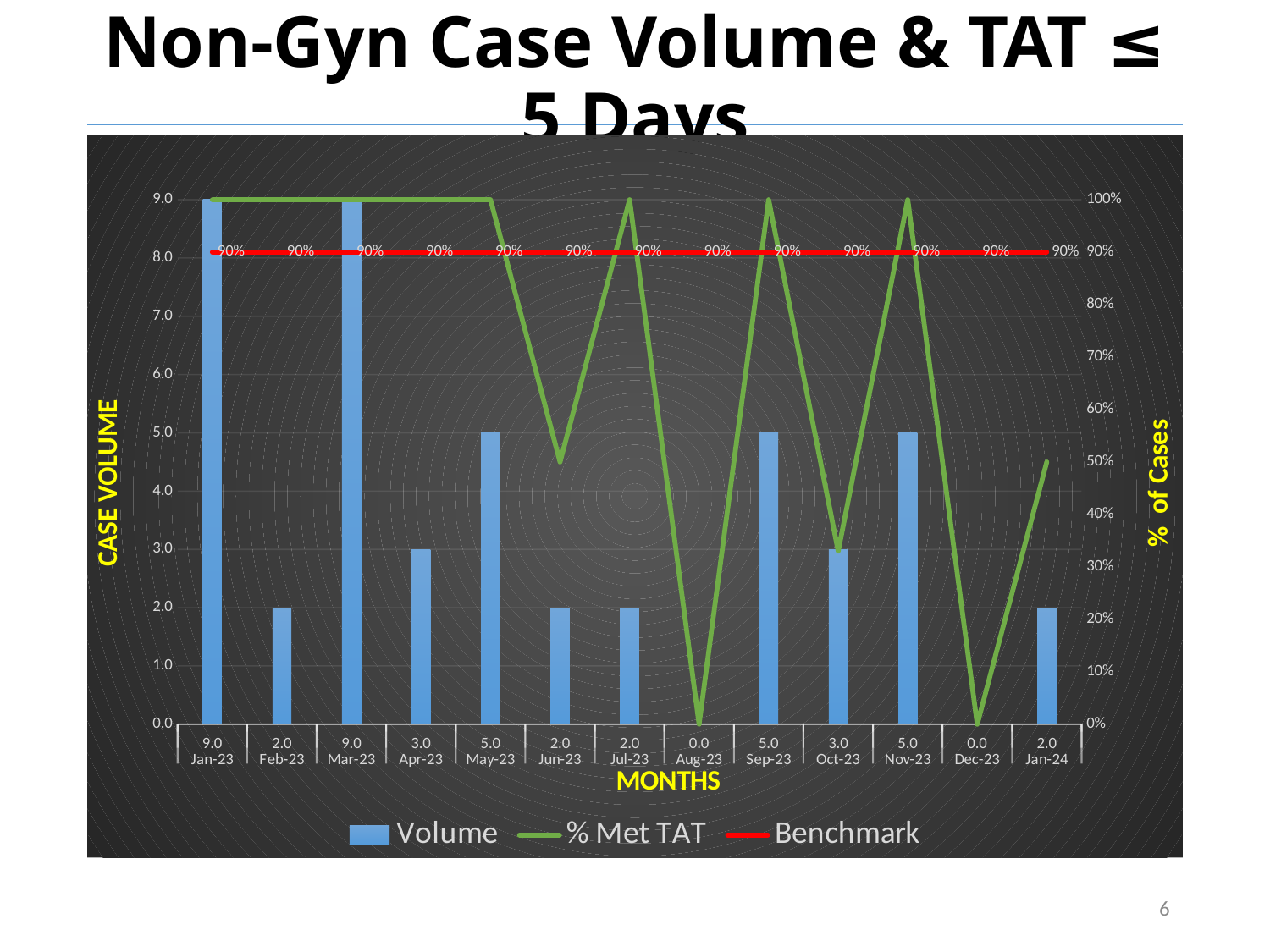
What are the three entries in the legend? Volume, % Met TAT, Benchmark Which month has the larger Volume, Sep-23 or Oct-23? Sep-23 Which months have the lowest Volume? Aug-23 and Dec-23 What is the Volume for Mar-23? 9.0 What is the Volume for May-23? 5.0 What value is the Benchmark line set at? 90% What kind of chart is this? Combination bar and line chart How many series does the legend list? 3 Is the % Met TAT value for Aug-23 greater or less than 10%? less How many months are shown on the x axis? 13 Is the % Met TAT value for Jun-23 greater or less than 90%? less What is the difference between the Volume for Jan-23 and the Volume for Feb-23? 7.0